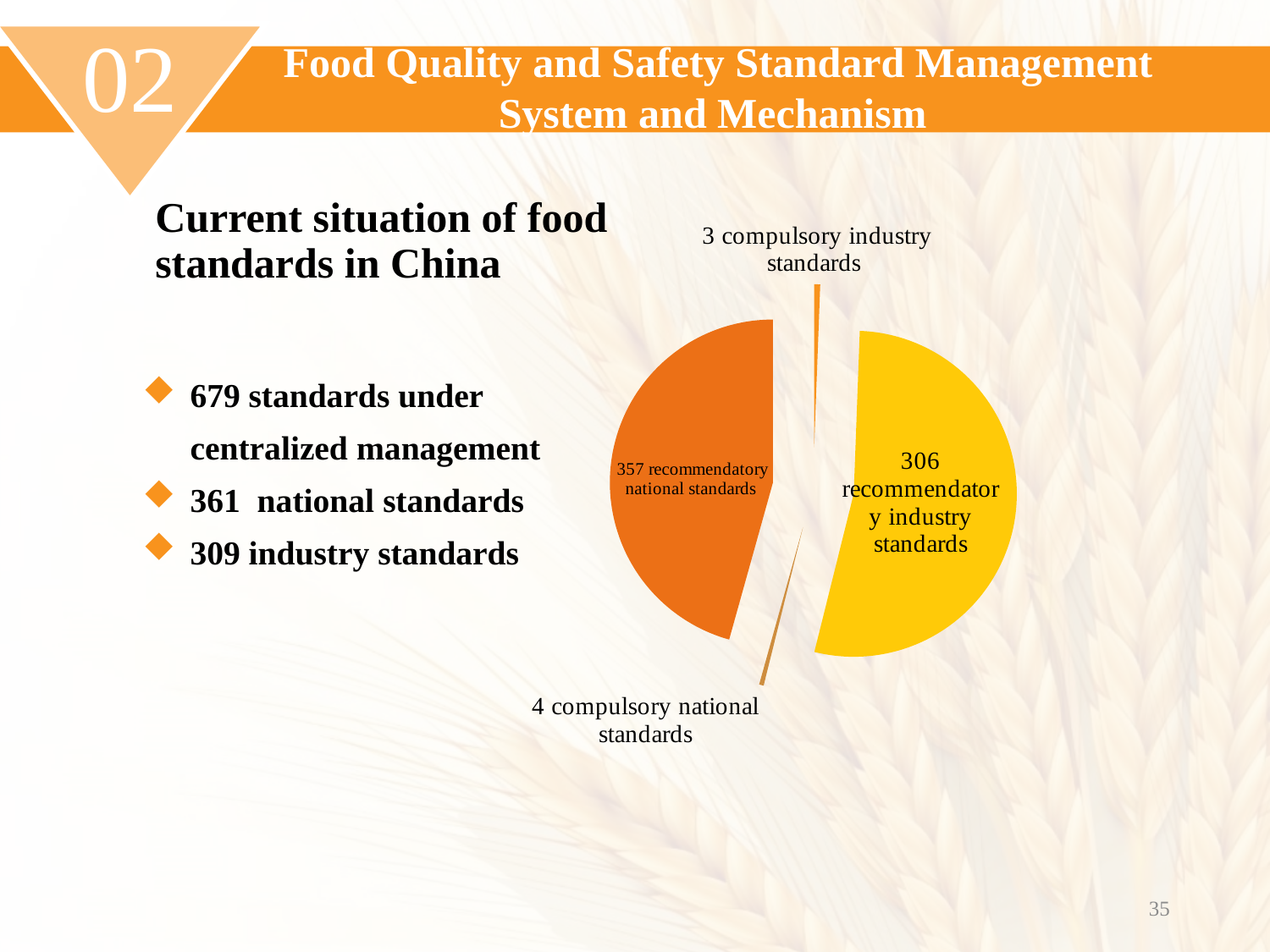
Which category has the largest slice in the pie chart? recommendatory national standards Which category has the smallest slice in the pie chart? compulsory industry standards How many recommendatory national standards does the pie chart show? 357 How many compulsory industry standards does the pie chart show? 3 How many recommendatory industry standards does the pie chart show? 306 What colour is the slice for recommendatory industry standards in the pie chart? yellow What is the difference between the number of recommendatory national standards and recommendatory industry standards in the pie chart? 51 What kind of chart is shown on the slide? pie chart Which is larger in the pie chart: compulsory national standards or compulsory industry standards? compulsory national standards What is the total of all four values shown in the pie chart? 670 How many compulsory national standards does the pie chart show? 4 How many slices does the pie chart have? 4